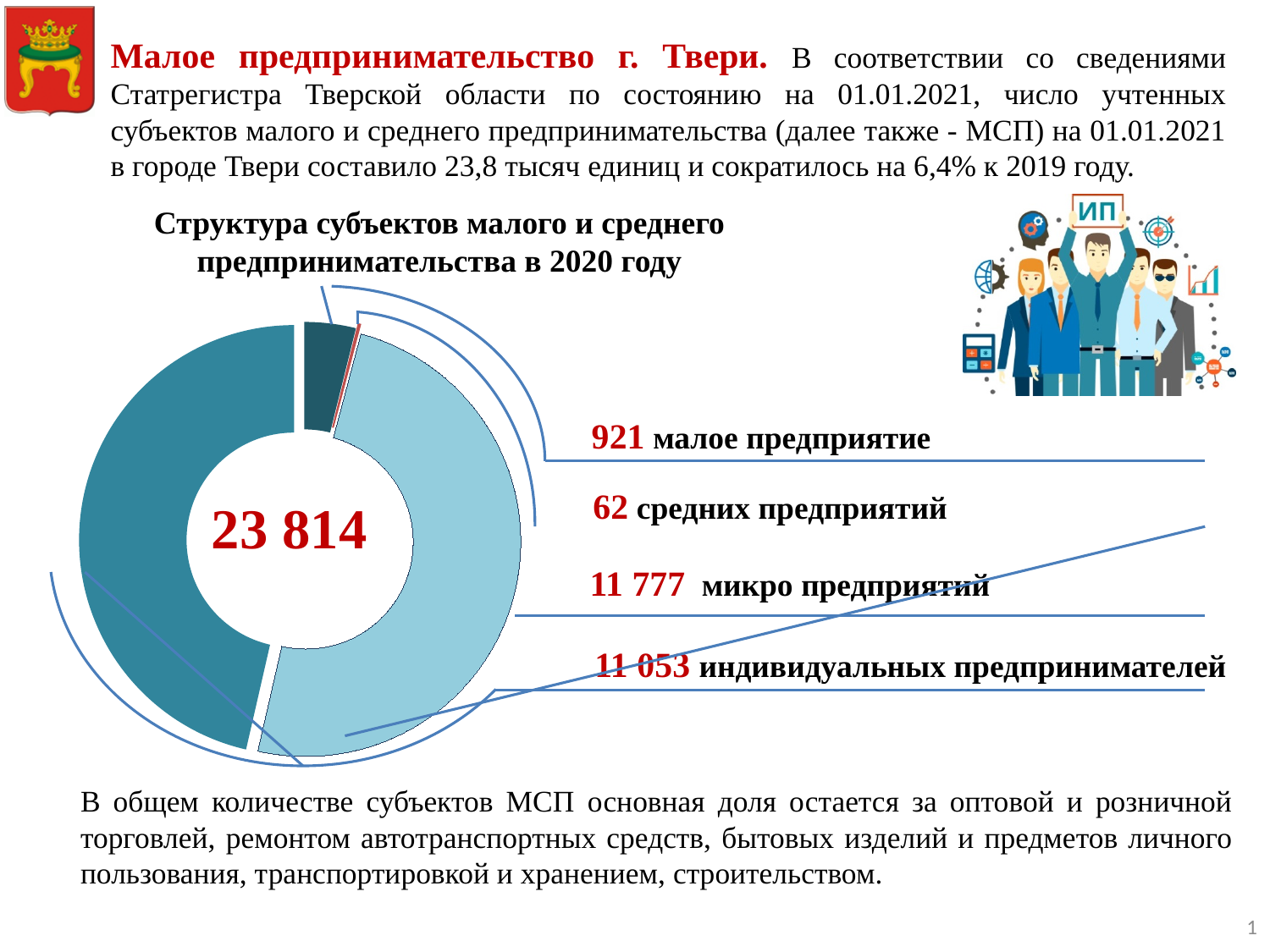
Which category has the largest number of subjects on the chart? микро предприятий Which is larger: the number of микро предприятий or the number of индивидуальных предпринимателей? микро предприятий Which category has the smallest number of subjects on the chart? средних предприятий How many categories of business subjects does the chart break down? 4 By how much does the number of микро предприятий exceed the number of индивидуальных предпринимателей? 724 How many малое предприятие (small enterprises) does the chart show? 921 What total number is printed in the centre of the doughnut chart? 23 814 What is the difference between the number of малое предприятие and средних предприятий? 859 What is the number of индивидуальных предпринимателей (individual entrepreneurs) on the chart? 11 053 How many средних предприятий (medium enterprises) does the chart show? 62 What is the number of микро предприятий (micro enterprises) on the chart? 11 777 What type of chart is used to show the structure of small and medium business subjects? Doughnut (pie) chart